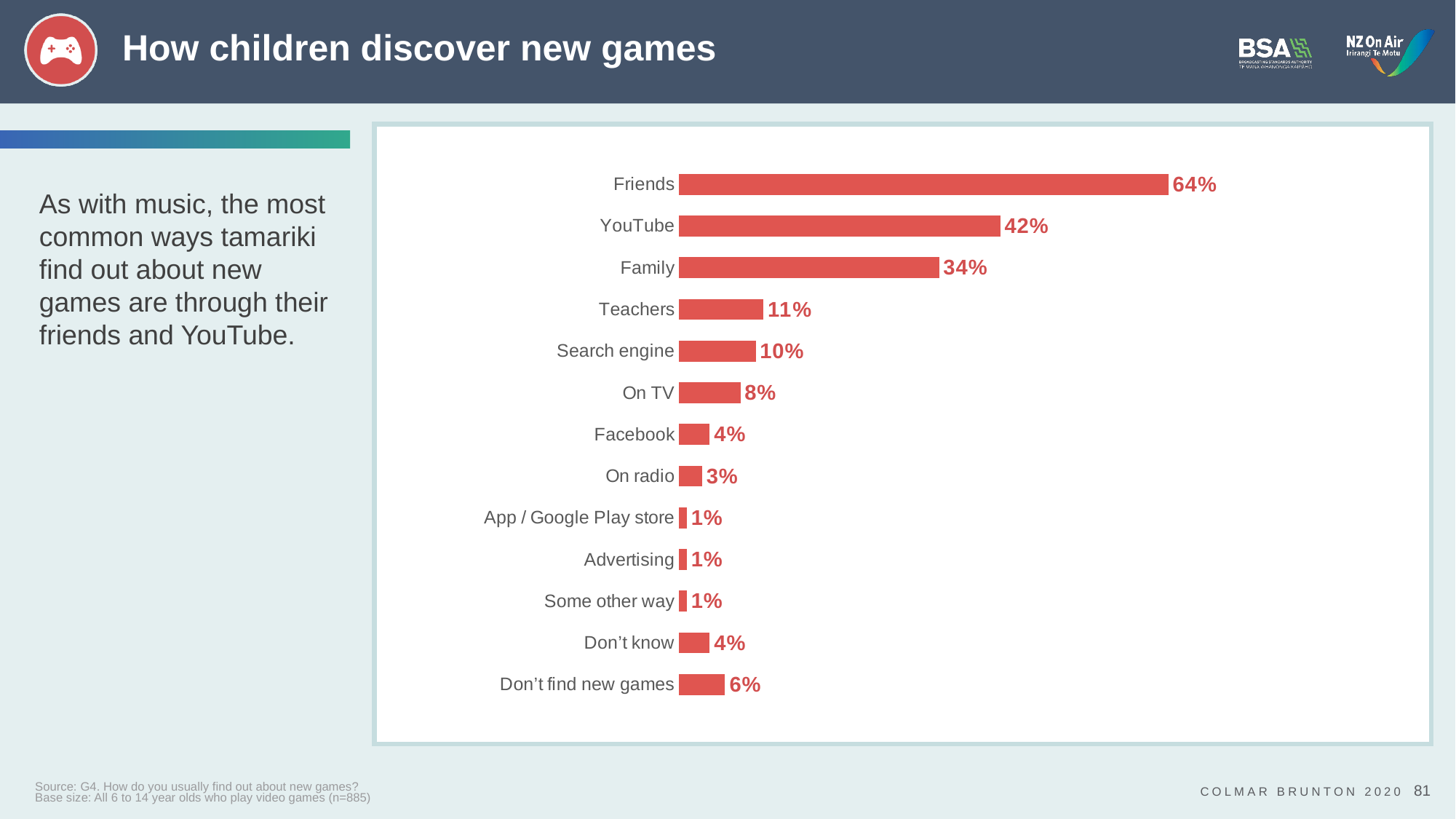
Which is larger, the value for Search engine or the value for On TV? Search engine What is the value for 'Don't find new games'? 6% What is the title of the slide containing the chart? How children discover new games What is the difference between the values for Family and Teachers? 23% What is the difference between the values for Friends and YouTube? 22% What is the value shown for YouTube? 42% What kind of chart is shown on the slide? Bar chart Which category has the highest value in the chart? Friends Which is larger, the value for Facebook or the value for On radio? Facebook What percentage of children discover new games through Friends? 64% What percentage of children find out about new games from Teachers? 11% How many categories are shown in the chart? 13